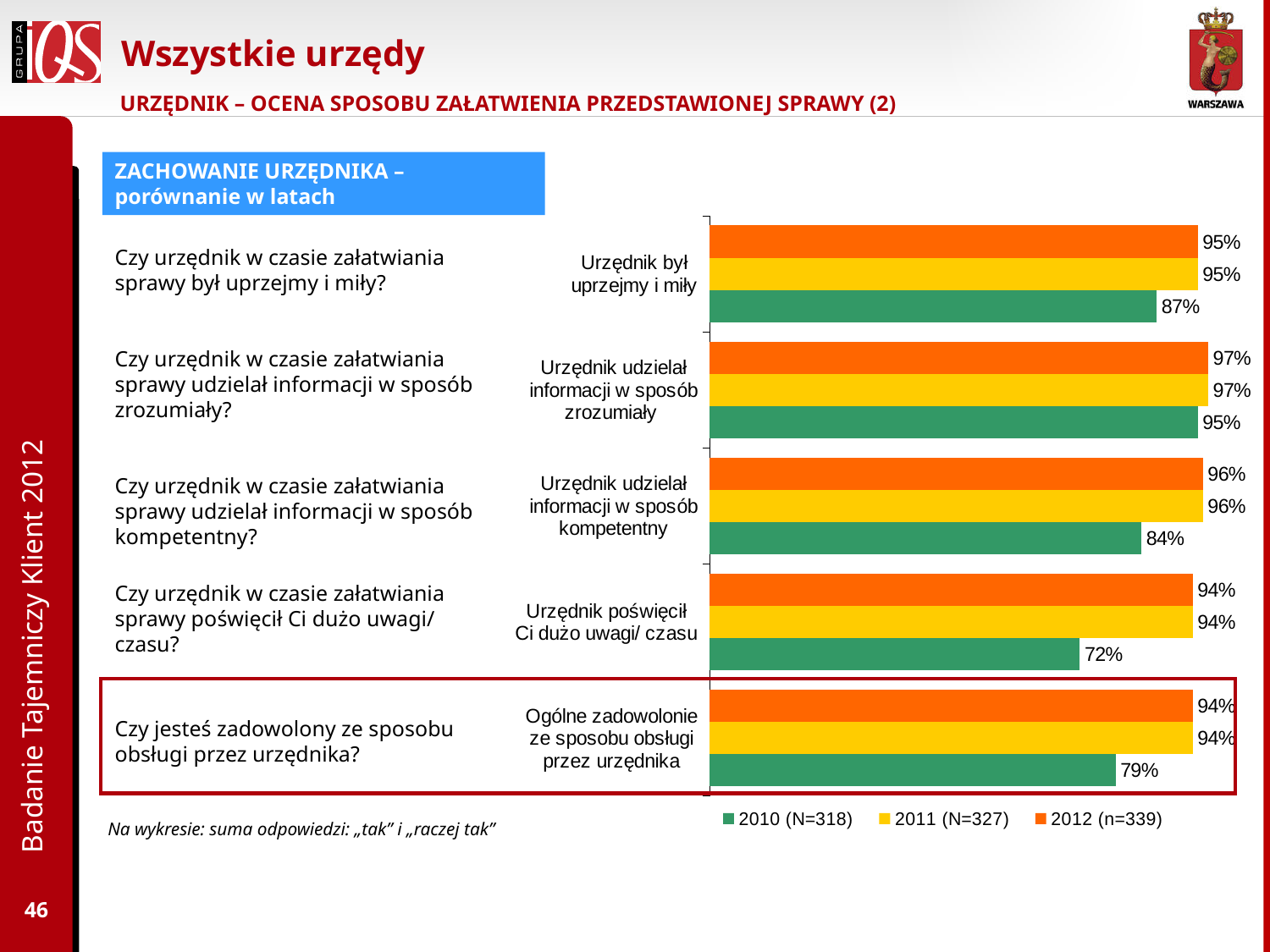
Which is larger for "Urzędnik był uprzejmy i miły": the 2010 value or the 2012 value? 2012 What is the 2012 value for "Urzędnik udzielał informacji w sposób zrozumiały"? 97% What kind of chart is shown on the slide? Bar chart Which category has the lowest 2010 value? Urzędnik poświęcił Ci dużo uwagi/ czasu What is the difference between the 2012 and 2010 values for "Urzędnik udzielał informacji w sposób kompetentny"? 12 percentage points What is the 2010 value for "Ogólne zadowolonie ze sposobu obsługi przez urzędnika"? 79% Which colour represents the 2011 (N=327) series in the legend? Yellow What is the 2010 value for "Urzędnik poświęcił Ci dużo uwagi/ czasu"? 72% What is the 2011 value for "Urzędnik był uprzejmy i miły"? 95% How many categories are shown on the chart? 5 Which category has the highest 2010 value? Urzędnik udzielał informacji w sposób zrozumiały How many series does the legend list? 3